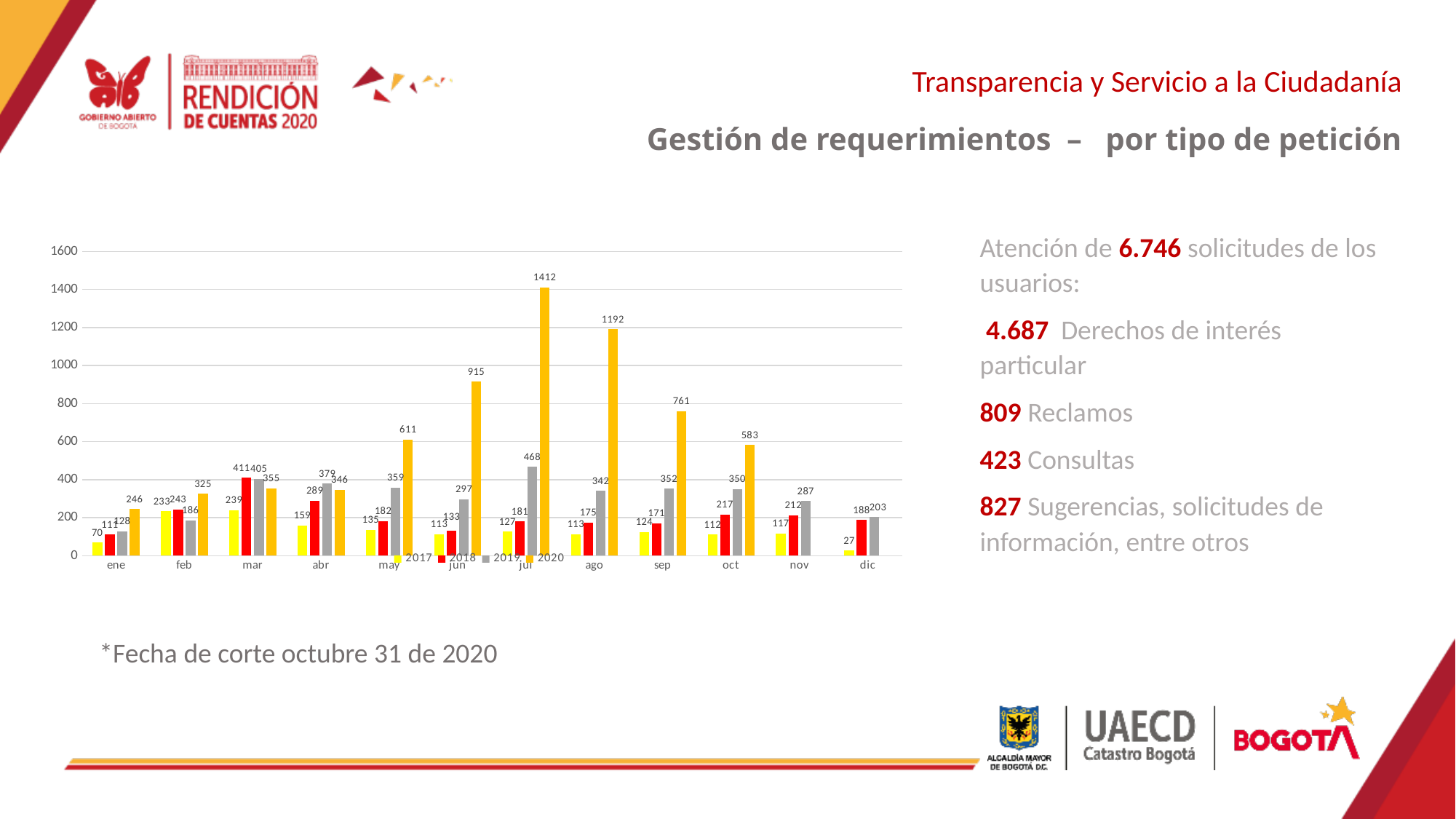
How many months are shown on the x axis? 12 In which month is the 2017 value lowest? dic What is the value for 2017 in feb? 233 Which is larger in mar: the 2018 value or the 2019 value? 2018 What is the difference between the 2020 values for jul and ago? 220 How many series does the legend list? 4 What is the title of the slide above the chart? Gestión de requerimientos – por tipo de petición What kind of chart is shown on the slide? bar chart In which month is the 2020 value highest? jul Do the 2020 values rise or fall from may to jul? rise What is the value for 2019 in abr? 379 What is the value for 2020 in jul? 1412